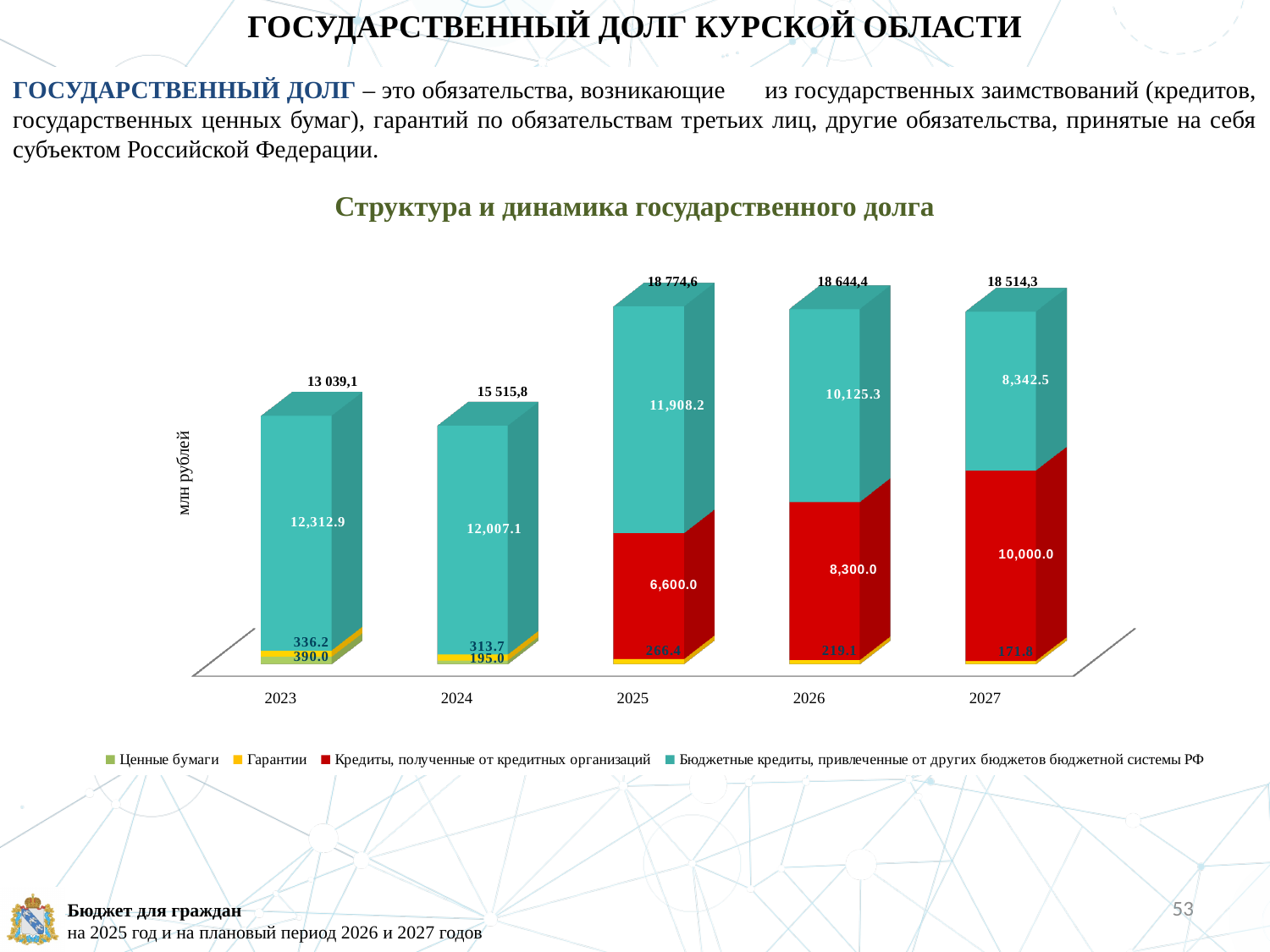
What is the difference between the total state debt in 2025 and in 2026? 130,2 Does the value of 'Бюджетные кредиты, привлеченные от других бюджетов бюджетной системы РФ' rise or fall from 2023 to 2027? fall What is the value of 'Бюджетные кредиты, привлеченные от других бюджетов бюджетной системы РФ' for 2023? 12,312.9 By how much does 'Кредиты, полученные от кредитных организаций' in 2027 exceed the value in 2026? 1,700.0 How many series does the legend list? 4 Which year has the highest total state debt? 2025 Which year has the lowest total state debt? 2023 What is the value of 'Кредиты, полученные от кредитных организаций' for 2027? 10,000.0 How many years are shown on the x axis of the chart? 5 What is the value of 'Гарантии' for 2024? 313.7 What is the total state debt shown above the bar for 2025? 18 774,6 Which is larger in 2027: 'Бюджетные кредиты, привлеченные от других бюджетов бюджетной системы РФ' or 'Кредиты, полученные от кредитных организаций'? Кредиты, полученные от кредитных организаций